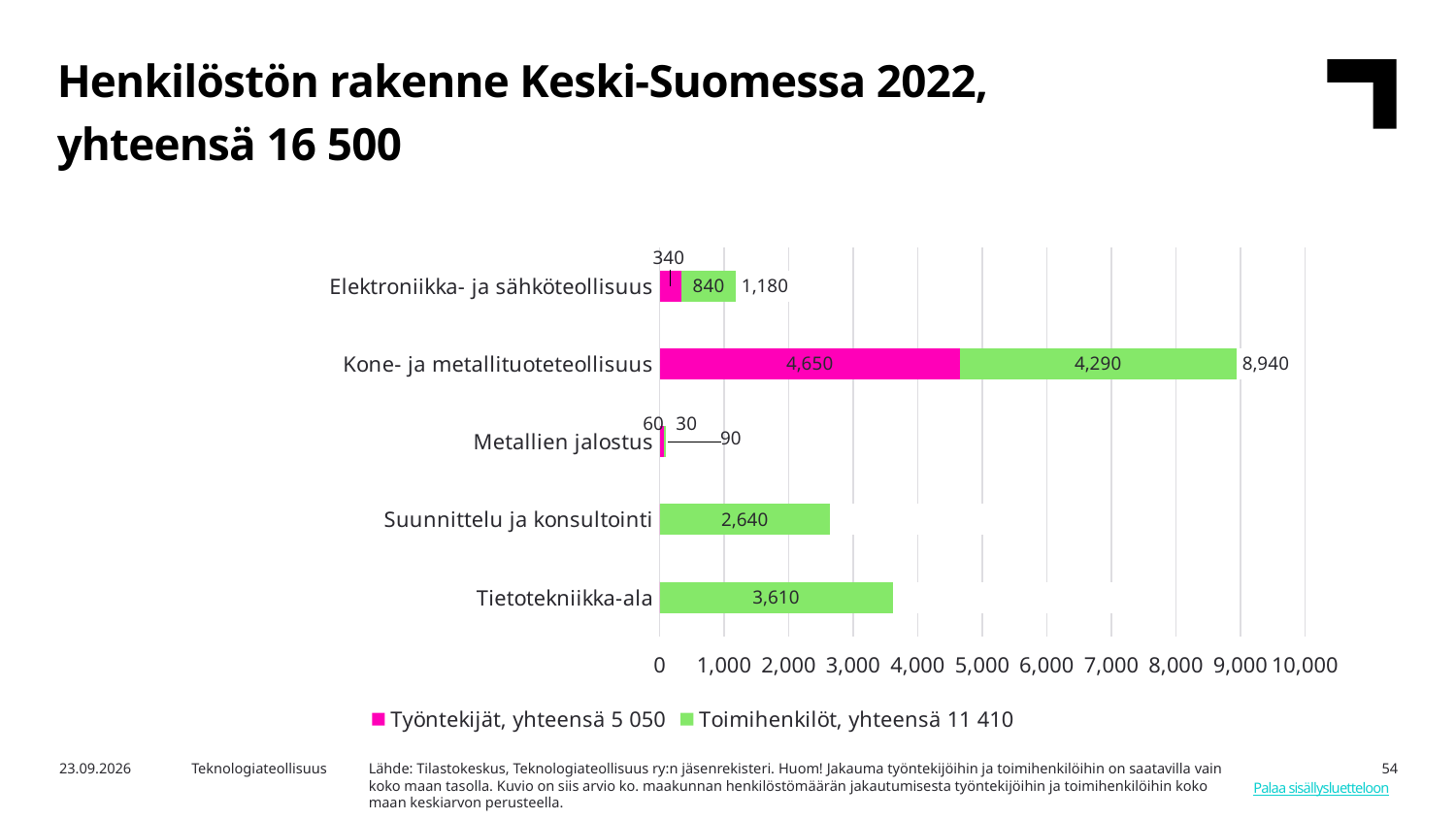
What is the Työntekijät value for Kone- ja metallituoteteollisuus? 4,650 Which category has the highest total value? Kone- ja metallituoteteollisuus What is the Toimihenkilöt value for Suunnittelu ja konsultointi? 2,640 What is the total of the stacked bar for Kone- ja metallituoteteollisuus? 8,940 How many series does the legend list? 2 Which category has the lowest total value? Metallien jalostus What is the Toimihenkilöt value for Tietotekniikka-ala? 3,610 What is the Toimihenkilöt value for Elektroniikka- ja sähköteollisuus? 840 Which is larger: the Toimihenkilöt value for Tietotekniikka-ala or for Suunnittelu ja konsultointi? Tietotekniikka-ala What is the total of the stacked bar for Metallien jalostus? 90 What is the difference between the Työntekijät and Toimihenkilöt values for Kone- ja metallituoteteollisuus? 360 How many categories are shown on the chart? 5